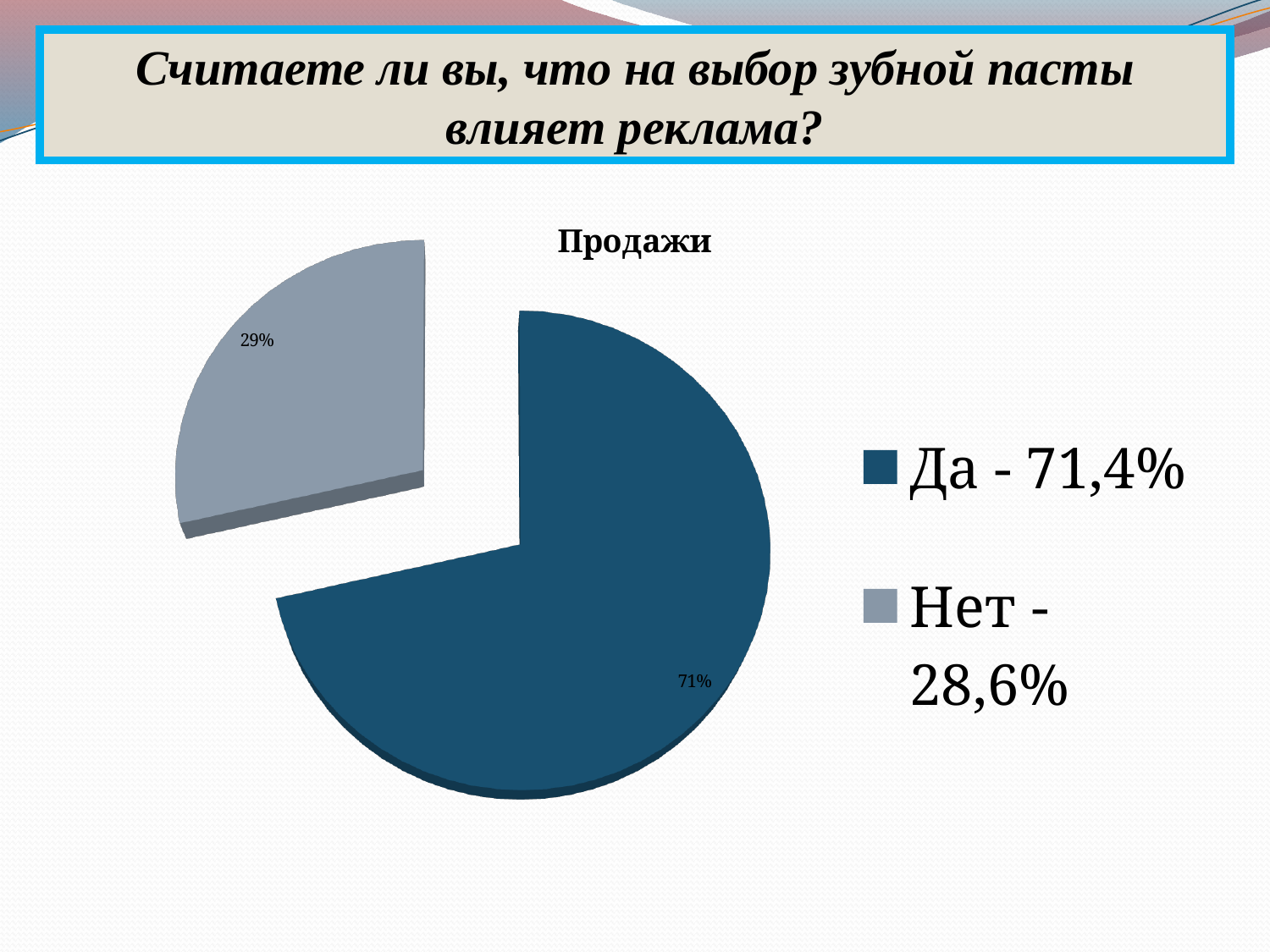
What is the difference between the data labels of the 'Да' slice and the 'Нет' slice? 42% What is the chart title? Продажи Which slice is the smallest? Нет - 28,6% What colour is the 'Да' slice? dark blue How many entries does the legend list? 2 Which slice is the largest? Да - 71,4% Which is larger, the 'Да' slice or the 'Нет' slice? Да What percentage label is shown on the light gray slice? 29% What percentage label is shown on the dark blue slice? 71% What kind of chart is shown on the slide? pie chart How many slices does the pie chart have? 2 What share of the pie does the 'Нет' slice represent according to the legend? 28,6%